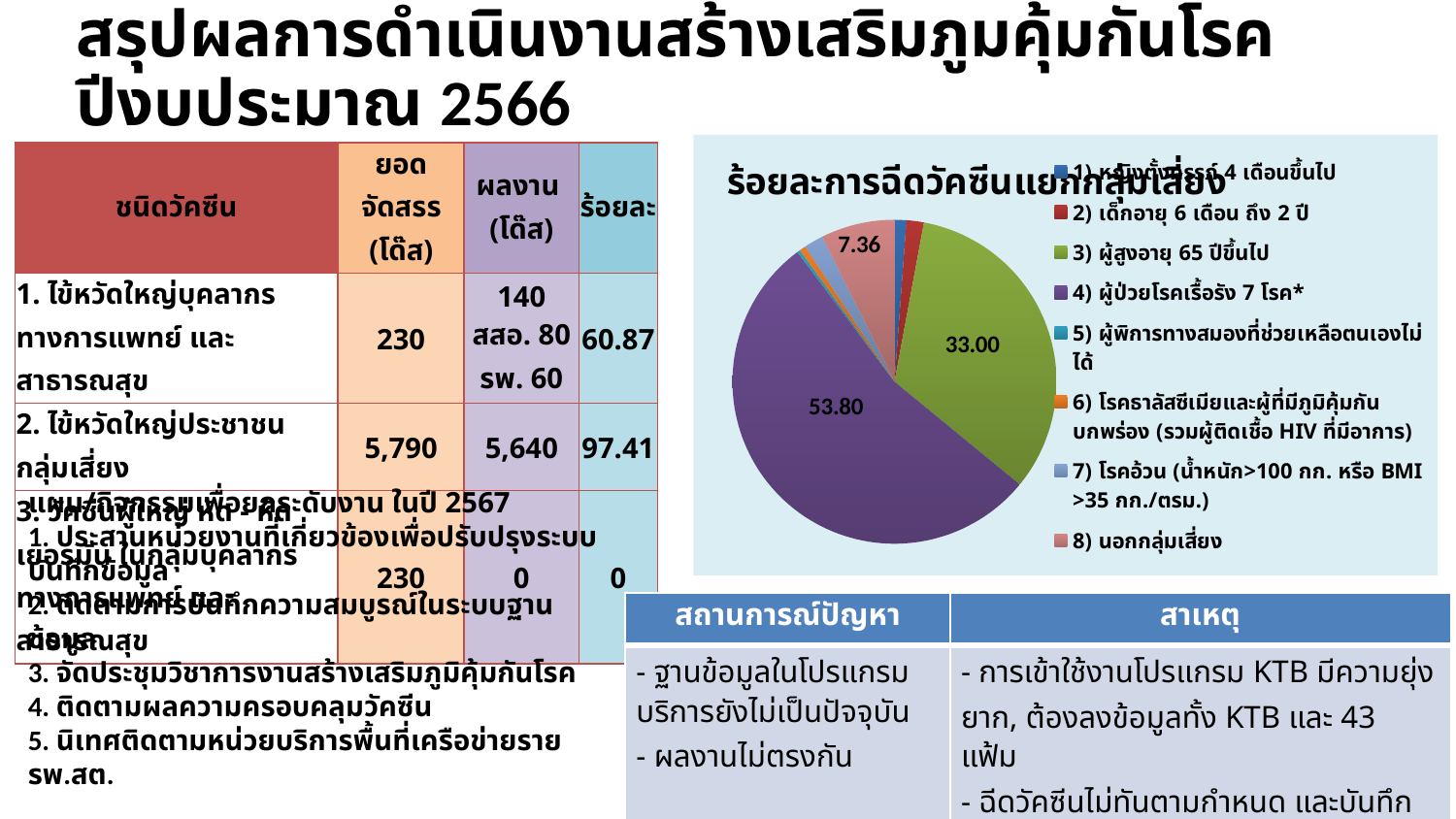
What is the difference between the values for ผู้สูงอายุ 65 ปีขึ้นไป and นอกกลุ่มเสี่ยง in the pie chart? 25.64 Which group has the largest slice in the pie chart? 4) ผู้ป่วยโรคเรื้อรัง 7 โรค* Which is larger in the pie chart: the slice for ผู้สูงอายุ 65 ปีขึ้นไป or the slice for นอกกลุ่มเสี่ยง? ผู้สูงอายุ 65 ปีขึ้นไป What is the title of the pie chart? ร้อยละการฉีดวัคซีนแยกกลุ่มเสี่ยง What is the value shown for 3) ผู้สูงอายุ 65 ปีขึ้นไป in the pie chart? 33.00 What kind of chart is shown on the slide? pie chart Which is larger in the pie chart: the slice for ผู้ป่วยโรคเรื้อรัง 7 โรค* or the slice for ผู้สูงอายุ 65 ปีขึ้นไป? ผู้ป่วยโรคเรื้อรัง 7 โรค* What is the value shown for 4) ผู้ป่วยโรคเรื้อรัง 7 โรค* in the pie chart? 53.80 How many categories does the pie chart's legend list? 8 What colour is the largest slice of the pie chart? purple What is the value shown for 8) นอกกลุ่มเสี่ยง in the pie chart? 7.36 What is the difference between the values for ผู้ป่วยโรคเรื้อรัง 7 โรค* and ผู้สูงอายุ 65 ปีขึ้นไป in the pie chart? 20.80